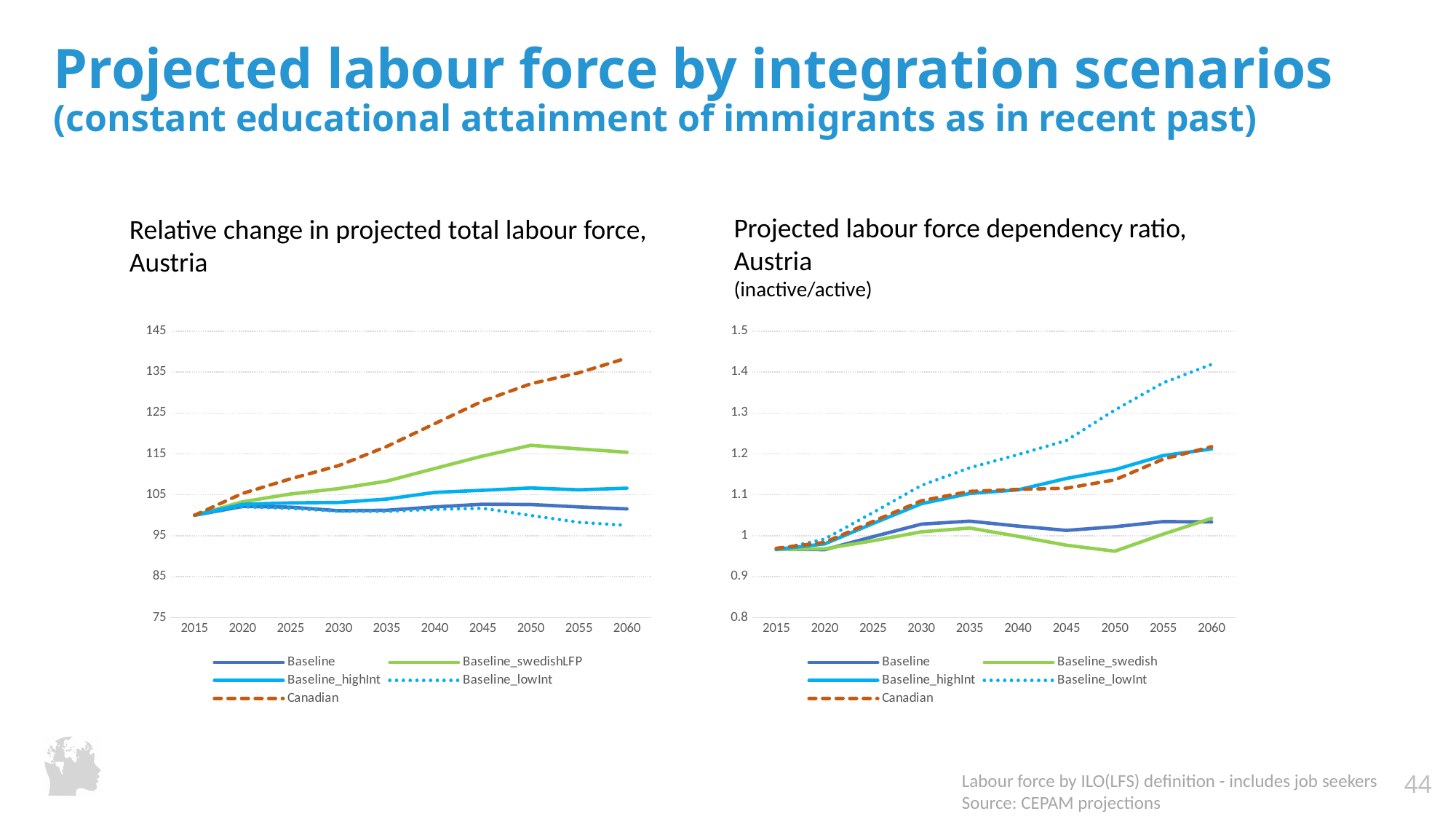
In the right chart, 'Projected labour force dependency ratio, Austria', which series has the highest value in 2060? Baseline_lowInt In the left chart, 'Relative change in projected total labour force, Austria', does the Canadian series rise or fall from 2015 to 2060? Rise How many series does the legend of the left chart, 'Relative change in projected total labour force, Austria', list? 5 What kind of chart is the left chart, 'Relative change in projected total labour force, Austria'? Line chart How many series does the legend of the right chart, 'Projected labour force dependency ratio, Austria', list? 5 In the right chart, 'Projected labour force dependency ratio, Austria', which series has the lowest value in 2050? Baseline_swedish In the left chart, 'Relative change in projected total labour force, Austria', is the value for Baseline_lowInt in 2060 greater or less than 105? less In the left chart, 'Relative change in projected total labour force, Austria', is the value for Canadian in 2060 greater or less than 135? greater In the left chart, 'Relative change in projected total labour force, Austria', which series has the lowest value in 2060? Baseline_lowInt How many years are plotted along the x axis of the left chart, 'Relative change in projected total labour force, Austria'? 10 In the left chart, 'Relative change in projected total labour force, Austria', which series has the highest value in 2060? Canadian In the right chart, 'Projected labour force dependency ratio, Austria', is the value for Baseline_lowInt in 2060 greater or less than 1.4? greater